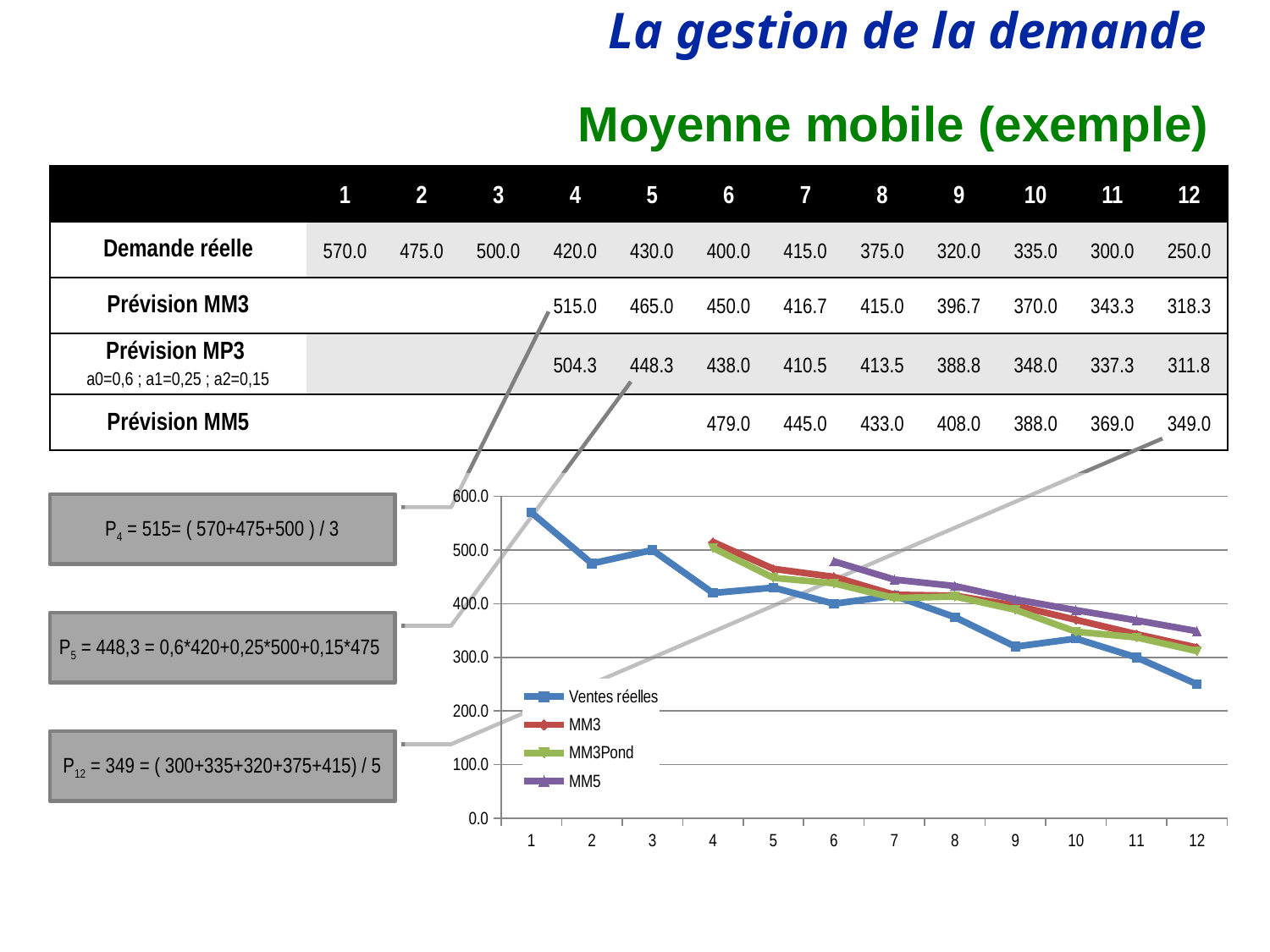
Is the value of Ventes réelles at period 1 greater or less than 500? greater At which period is the Ventes réelles series highest? 1 What kind of chart is shown on the slide? line chart Do the values of the Ventes réelles series rise or fall from period 1 to period 12? fall How many periods are shown along the x axis of the chart? 12 Is the value of Ventes réelles at period 12 greater or less than 300? less At which period is the Ventes réelles series lowest? 12 Which series in the chart starts at period 6? MM5 At period 12, which is larger: the MM5 series or the Ventes réelles series? MM5 How many series does the chart legend list? 4 Is the value of Ventes réelles at period 2 greater or less than 500? less At period 6, which is larger: the MM5 series or the Ventes réelles series? MM5